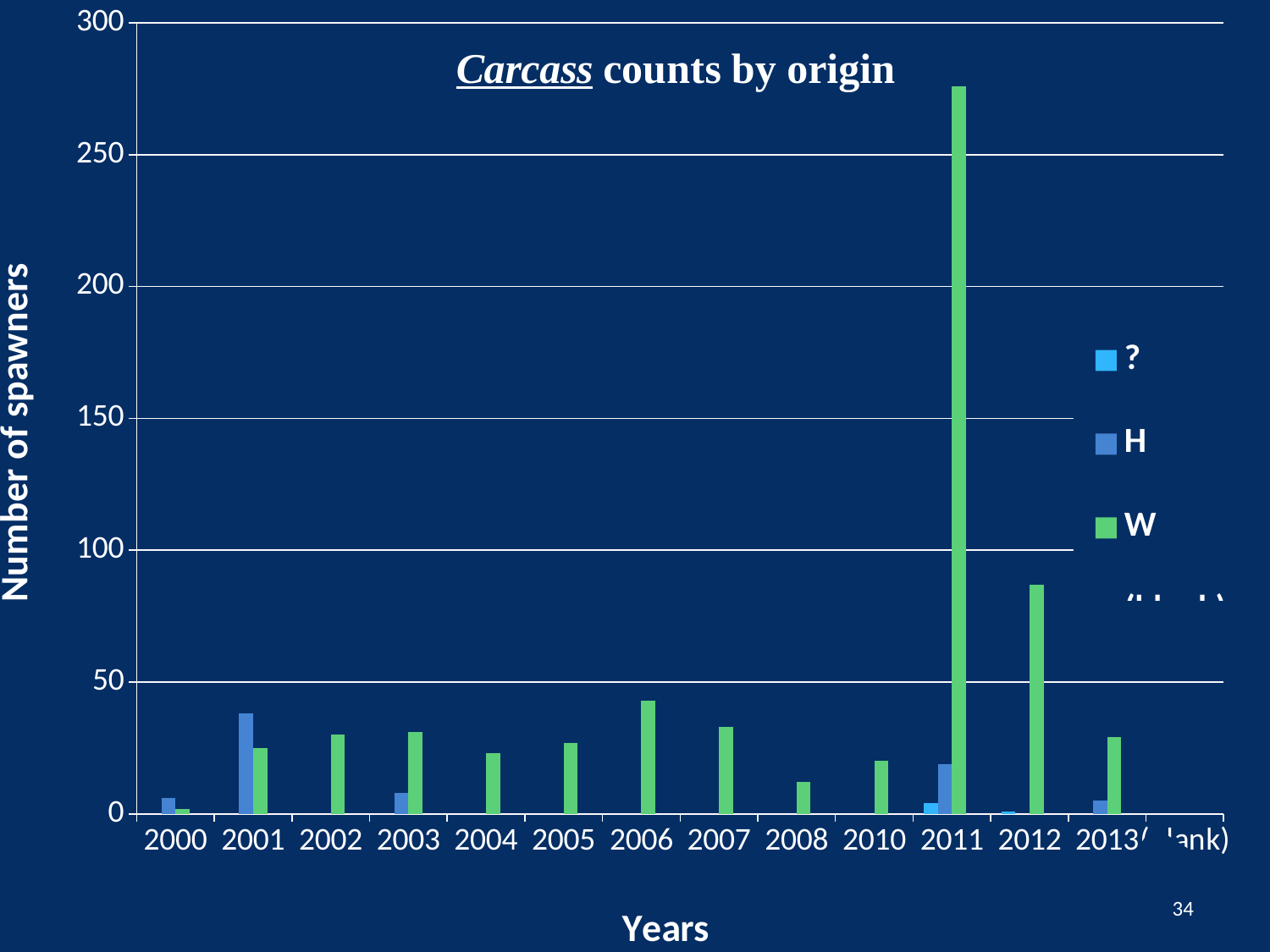
What kind of chart is shown on the slide? bar chart Is the value for W in 2012 greater or less than 100? less Which year has the larger W value, 2011 or 2012? 2011 Is the value for W in 2006 greater or less than 50? less What is the label on the vertical axis of the chart? Number of spawners In which year is the W series highest? 2011 What is the title of the chart? Carcass counts by origin Is the value for H in 2001 greater or less than 50? less In 2001, which series has the larger value, H or W? H Which year has the larger W value, 2006 or 2008? 2006